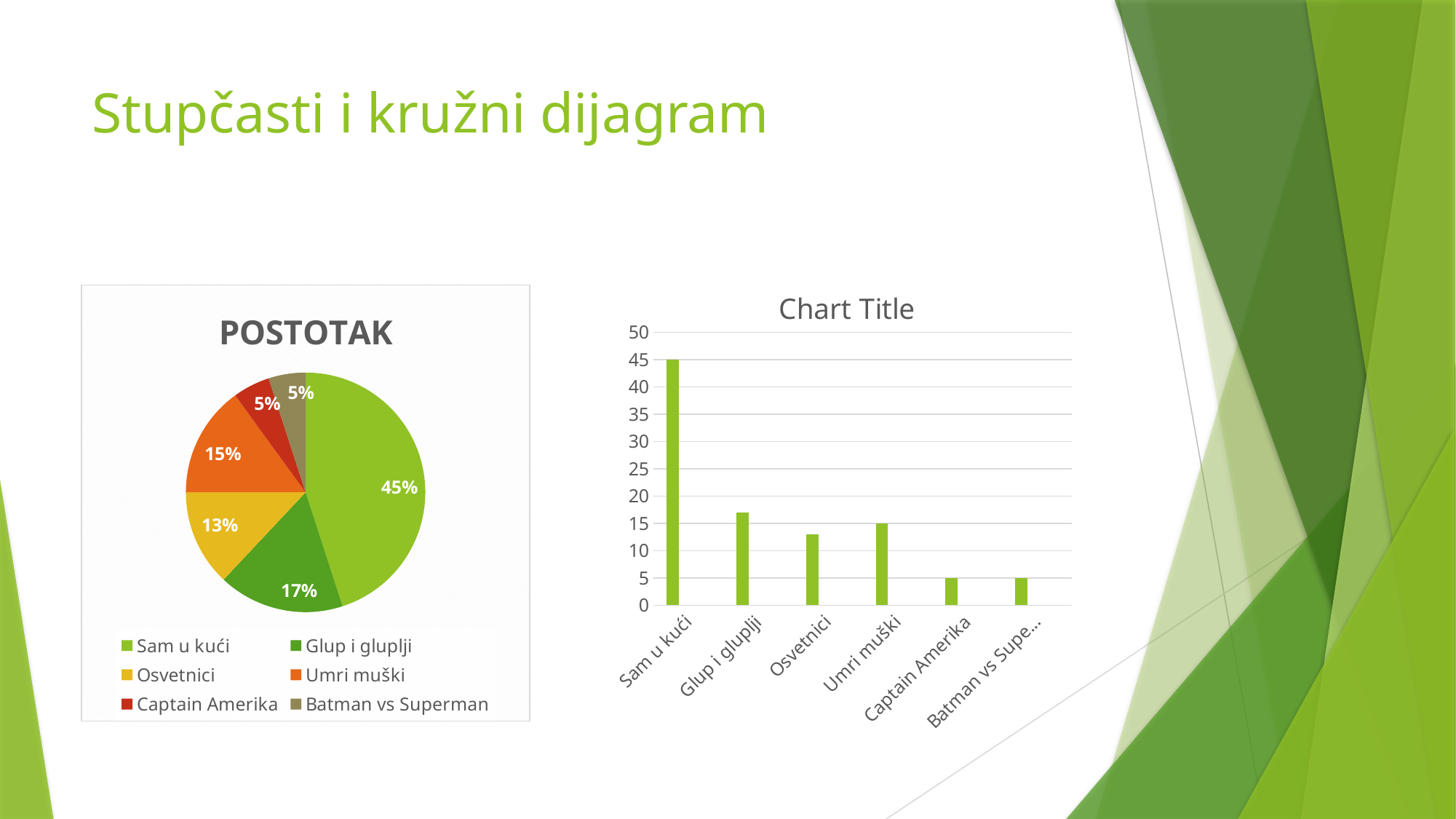
In the bar chart titled Chart Title, which category has the tallest bar? Sam u kući In the bar chart titled Chart Title, is the value for Glup i gluplji greater or less than 15? greater In the POSTOTAK pie chart, what share does Sam u kući have? 45% In the POSTOTAK pie chart, what share does Osvetnici have? 13% In the POSTOTAK pie chart, what share does Umri muški have? 15% What kind of chart is the chart titled Chart Title on the right? bar chart How many categories does the legend of the POSTOTAK pie chart list? 6 In the bar chart titled Chart Title, is the value for Osvetnici greater or less than 15? less In the POSTOTAK pie chart, which is larger, the share of Umri muški or the share of Osvetnici? Umri muški In the POSTOTAK pie chart, what is the difference between the shares of Glup i gluplji and Osvetnici? 4% In the bar chart titled Chart Title, what is the value for Captain Amerika? 5 In the POSTOTAK pie chart, which category has the largest slice? Sam u kući